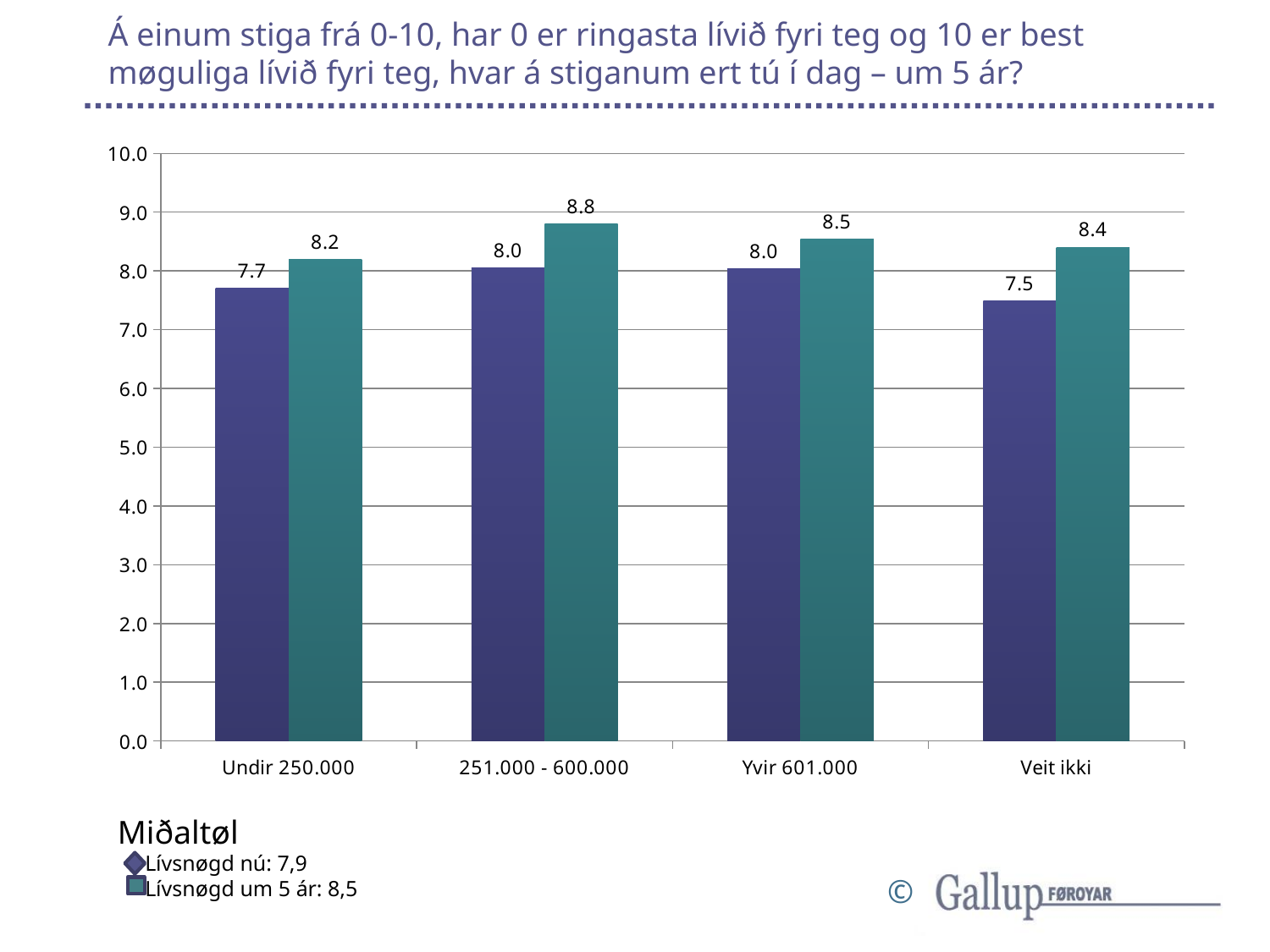
What average (Miðaltøl) is given for Lívsnøgd um 5 ár in the legend? 8,5 Which is larger for Undir 250.000: Lívsnøgd nú or Lívsnøgd um 5 ár? Lívsnøgd um 5 ár Which category has the lowest value for Lívsnøgd nú? Veit ikki How many categories are shown on the x axis? 4 What kind of chart is shown on the slide? Bar chart What is the value of Lívsnøgd um 5 ár for Yvir 601.000? 8.5 What is the difference between Lívsnøgd um 5 ár and Lívsnøgd nú for Veit ikki? 0.9 What is the value of Lívsnøgd um 5 ár for 251.000 - 600.000? 8.8 What is the value of Lívsnøgd nú for Veit ikki? 7.5 What is the value of Lívsnøgd nú for Undir 250.000? 7.7 How many series does the legend list? 2 Which category has the highest value for Lívsnøgd um 5 ár? 251.000 - 600.000